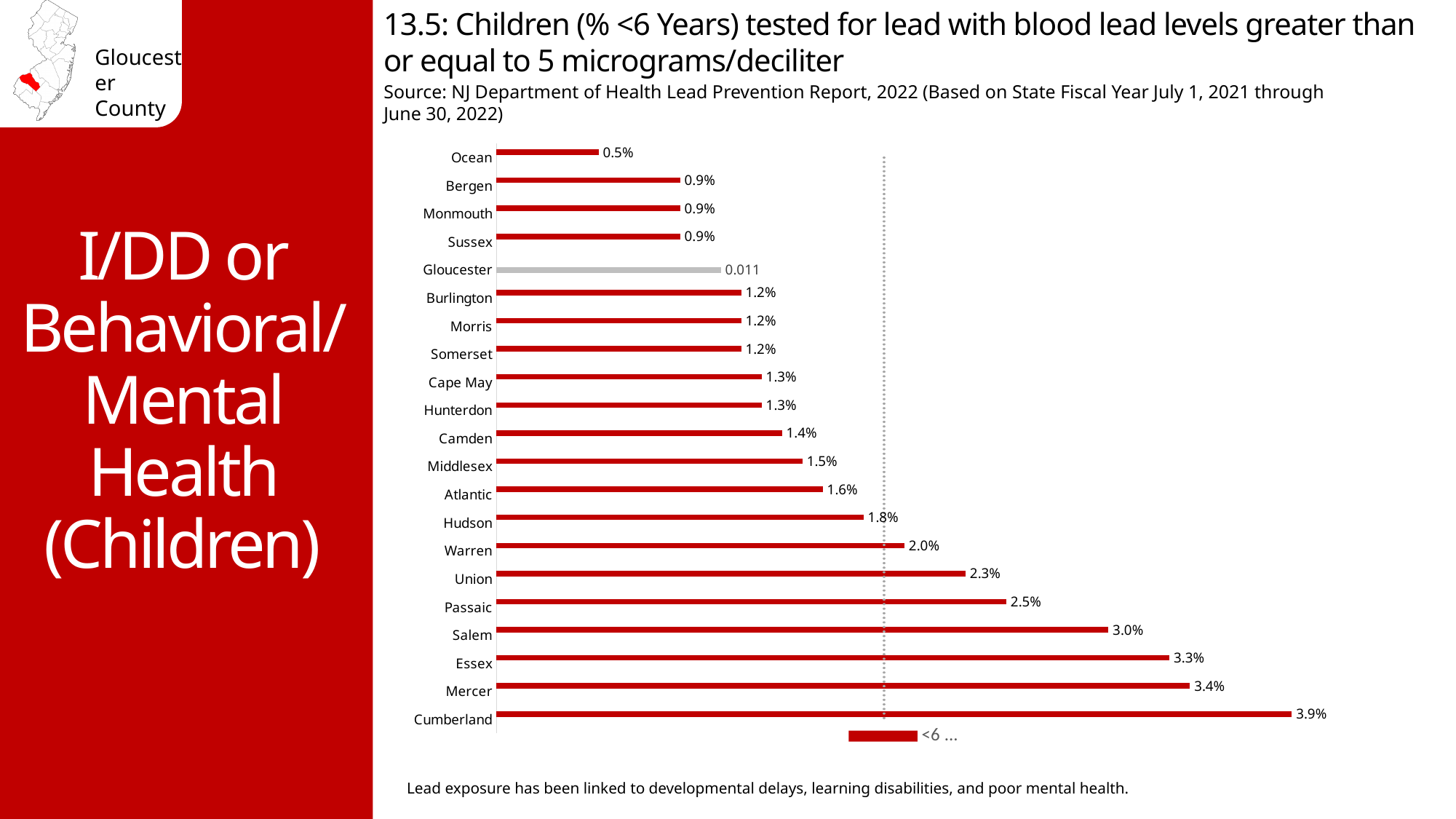
Do the bar values increase or decrease going from the top of the chart (Ocean) to the bottom (Cumberland)? Increase What label is printed next to the Gloucester bar? 0.011 Which county's bar is drawn in grey rather than red? Gloucester Which county has the highest percentage of children with elevated blood lead levels? Cumberland What is the value shown for Camden? 1.4% What kind of chart is shown on the slide? Bar chart What is the difference between the values for Cumberland and Ocean? 3.4 percentage points What is the value shown for Salem? 3.0% What is the difference between the values for Mercer and Essex? 0.1 percentage points How many counties are plotted in the chart? 21 Which has a higher value, Hudson or Atlantic? Hudson Which county has the lowest percentage of children with elevated blood lead levels? Ocean